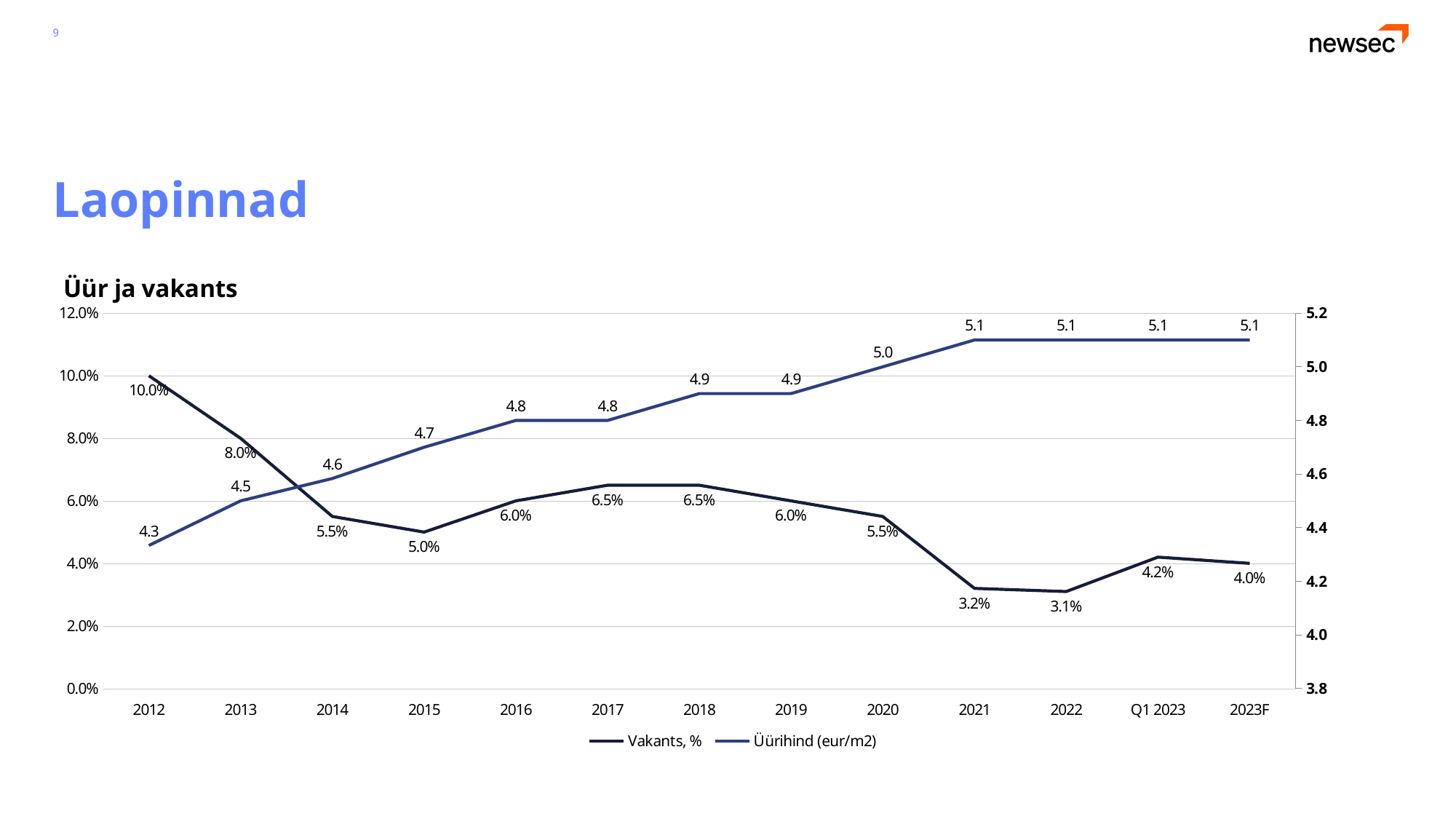
How many points along the x axis does the "Üür ja vakants" chart have? 13 What is the difference between Vakants, % in 2012 and in 2013? 2.0% What is the value of Üürihind (eur/m2) in 2016? 4.8 In which year is Vakants, % at its lowest? 2022 Which is larger: Vakants, % in 2017 or in 2020? 2017 What is the difference between Üürihind (eur/m2) in 2021 and in 2012? 0.8 What is the value of Vakants, % in 2012? 10.0% Does Üürihind (eur/m2) generally rise or fall from 2012 to 2023F? Rise In which year is Vakants, % at its highest? 2012 What is the value of Vakants, % in 2022? 3.1% How many series does the legend of the "Üür ja vakants" chart list? 2 What type of chart is shown under the title "Üür ja vakants"? Line chart